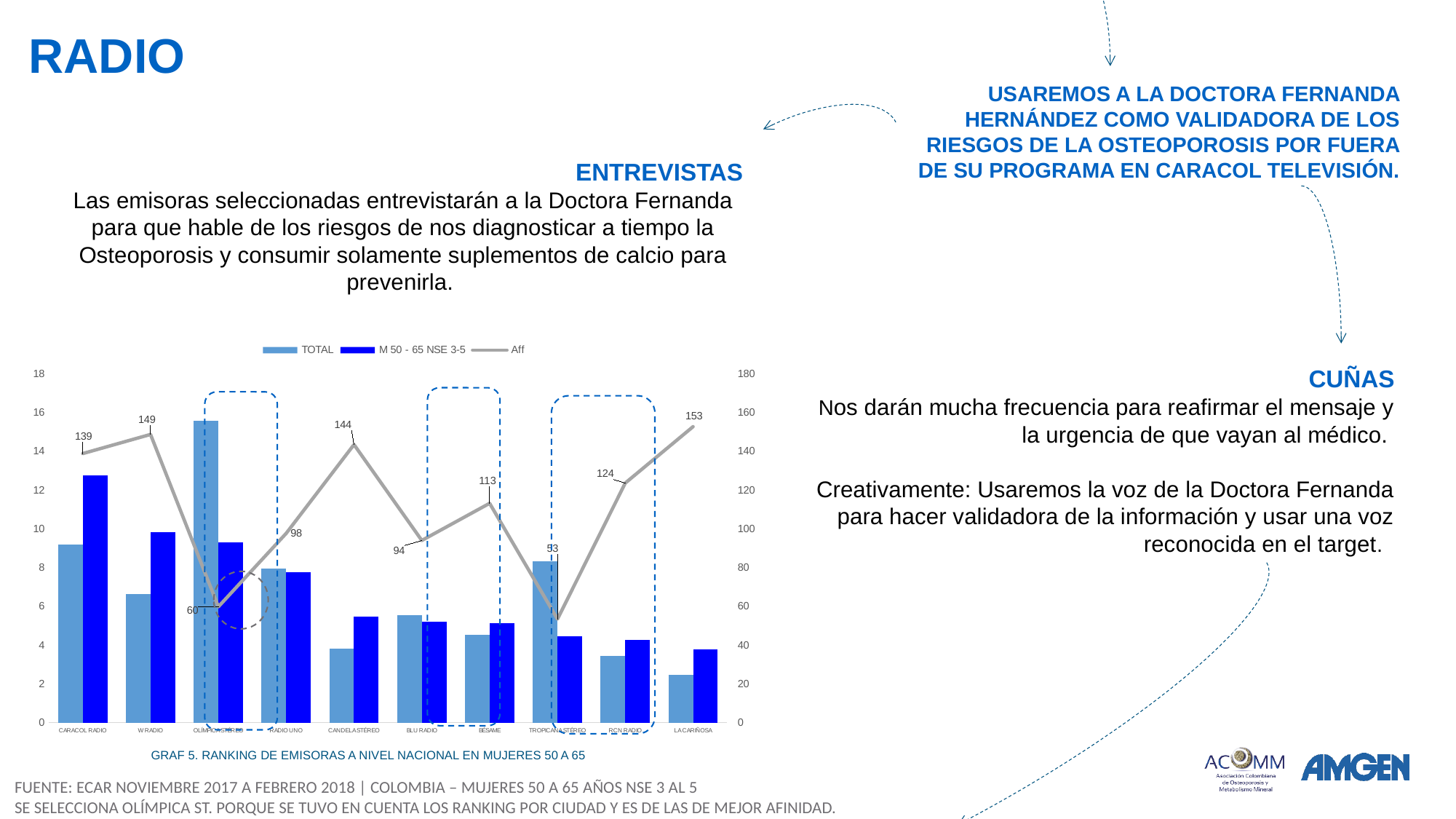
What is the Aff value for Bésame? 113 How many series does the legend list? 3 Is the TOTAL value for La Cariñosa greater or less than 4? less What is the difference between the Aff values of Candela Stéreo and Blu Radio? 50 Which station has the highest Aff value? La Cariñosa Which has a higher Aff value, Caracol Radio or RCN Radio? Caracol Radio What is the Aff value for Olímpica Stéreo? 60 Is the TOTAL value for Caracol Radio greater or less than 8? greater How many radio stations are shown on the x axis? 10 Which station has the lowest Aff value? Tropicana Stéreo Which station has the tallest TOTAL bar? Olímpica Stéreo What is the Aff value for W Radio? 149